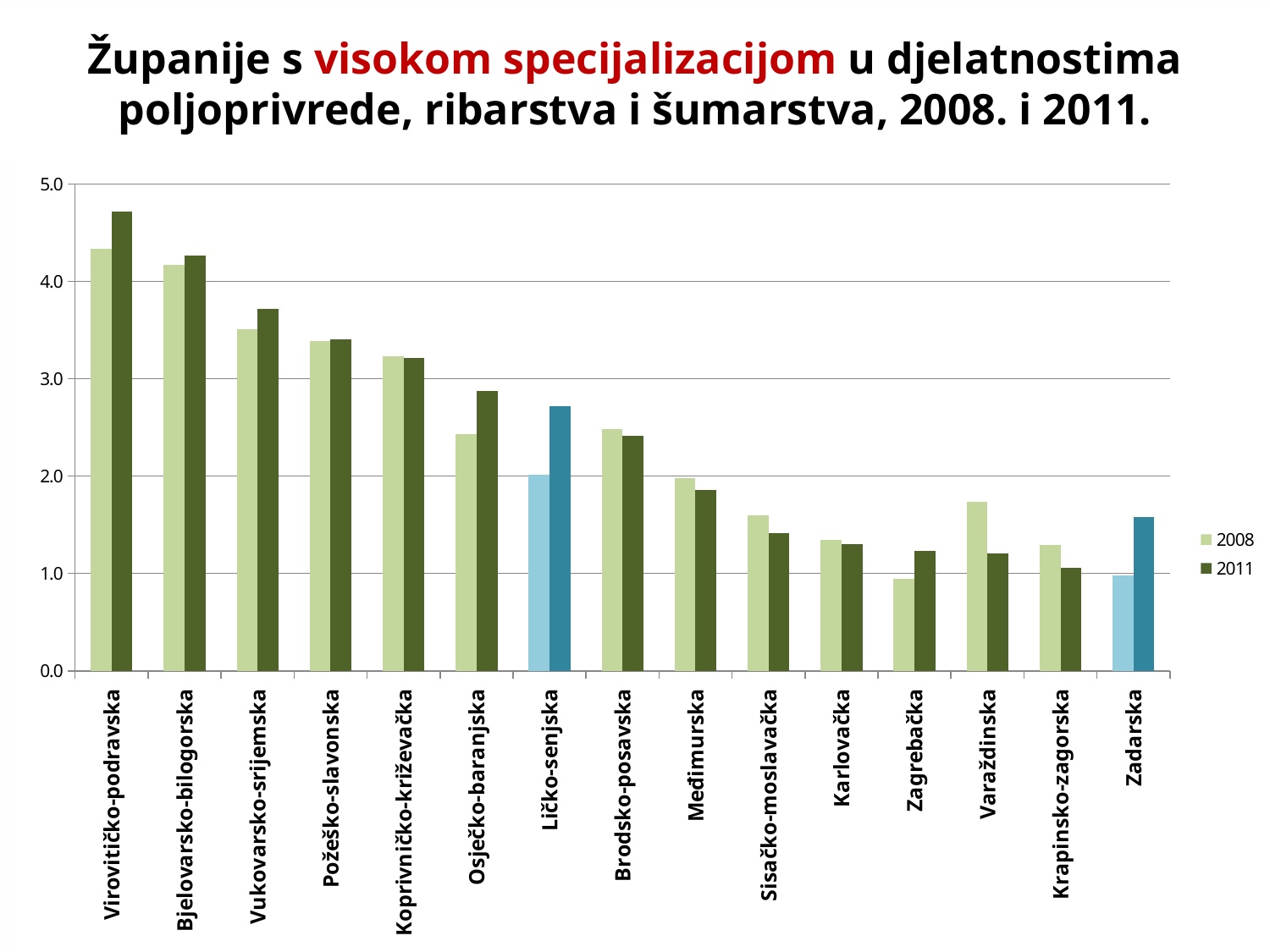
What kind of chart is shown on the slide? bar chart Is the 2011 value for Osječko-baranjska greater or less than 3.0? less Do the 2011 values generally rise or fall from left to right along the x axis? fall Is the 2008 value for Vukovarsko-srijemska greater or less than 3.0? greater How many series does the legend list? 2 Is the 2011 value for Zadarska greater or less than 1.0? greater For Varaždinska, which year has the larger value, 2008 or 2011? 2008 For Ličko-senjska, which year has the larger value, 2008 or 2011? 2011 Which county has the highest value for 2008? Virovitičko-podravska Which county has the highest value for 2011? Virovitičko-podravska How many counties (categories) are shown on the x axis? 15